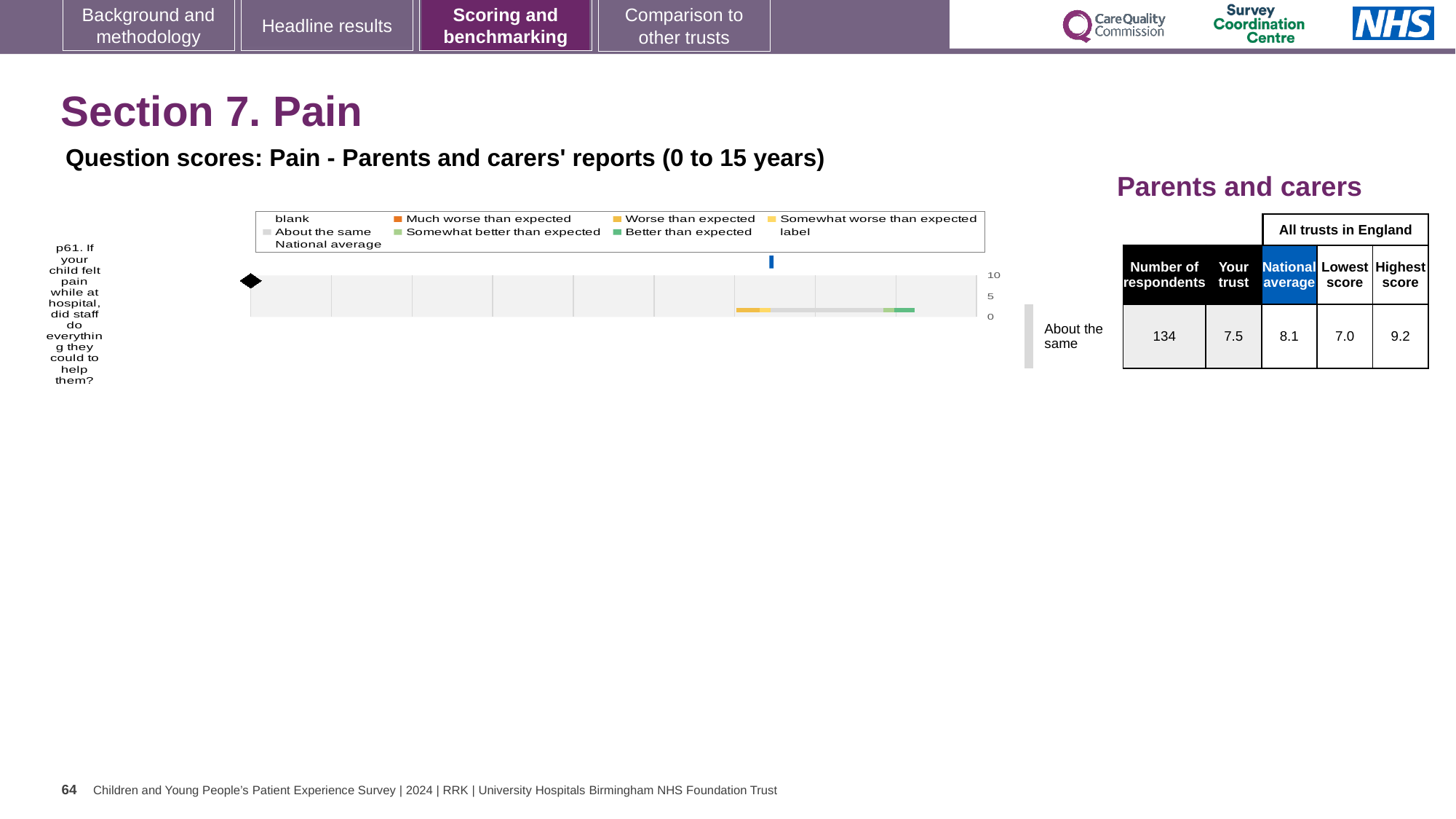
Which legend entry in the chart is represented by the blue marker? National average What is the difference between the national average (8.1) and the 'Your trust' score (7.5) for question p61? 0.6 What is the difference between the highest score (9.2) and the lowest score (7.0) for question p61? 2.2 According to the table next to the chart, what is the highest score among all trusts in England for question p61? 9.2 According to the table next to the chart, what is the lowest score among all trusts in England for question p61? 7.0 According to the table next to the chart, what is the national average score for question p61? 8.1 What is the highest value shown on the chart's numeric axis? 10 Which is larger for question p61: the 'Your trust' score or the national average? National average How many survey questions are plotted in the chart? 1 What kind of chart is shown on the slide? bar chart According to the table next to the chart, what is the 'Your trust' score for question p61? 7.5 According to the table next to the chart, how many respondents answered question p61? 134